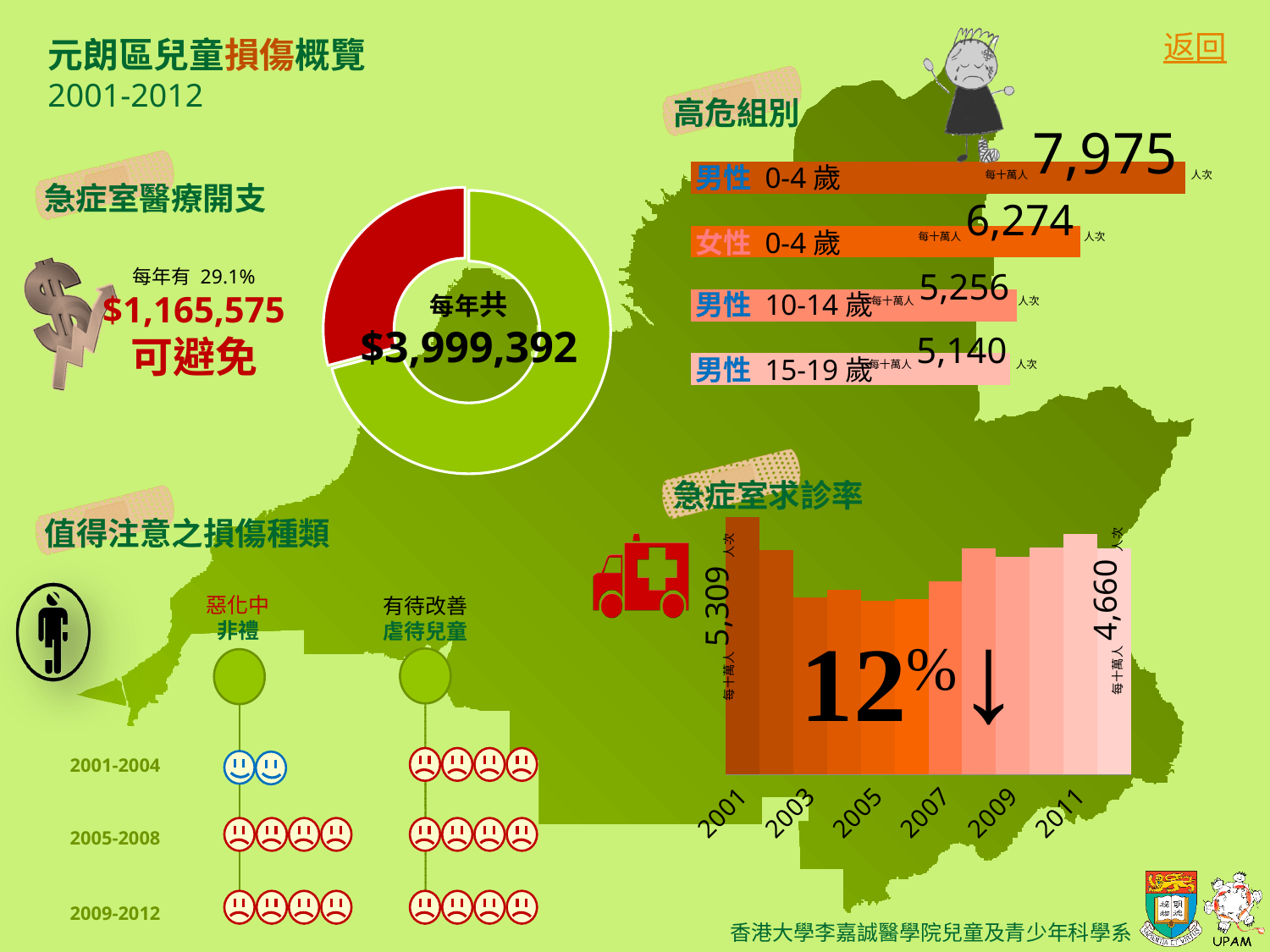
In the 急症室醫療開支 donut chart, what is the total annual amount shown in the centre? $3,999,392 In the 高危組別 bar chart, what is the difference between 男性 0-4 歲 and 女性 0-4 歲? 1,701 In the 急症室求診率 bar chart, what is the value for 2001? 5,309 In the 高危組別 bar chart, how many groups are shown? 4 In the 高危組別 bar chart, what is the value for 男性 0-4 歲? 7,975 In the 高危組別 bar chart, what is the value for 女性 0-4 歲? 6,274 What kind of chart is the 急症室醫療開支 chart? Donut chart In the 急症室求診率 bar chart, do the values overall rise or fall from 2001 to the last year? Fall In the 高危組別 bar chart, which group has the lowest value? 男性 15-19 歲 In the 急症室醫療開支 donut chart, what share of the total is marked as 可避免? 29.1% In the 高危組別 bar chart, which group has the highest value? 男性 0-4 歲 In the 急症室求診率 bar chart, what is the difference between the 2001 value and the final-year value of 4,660? 649